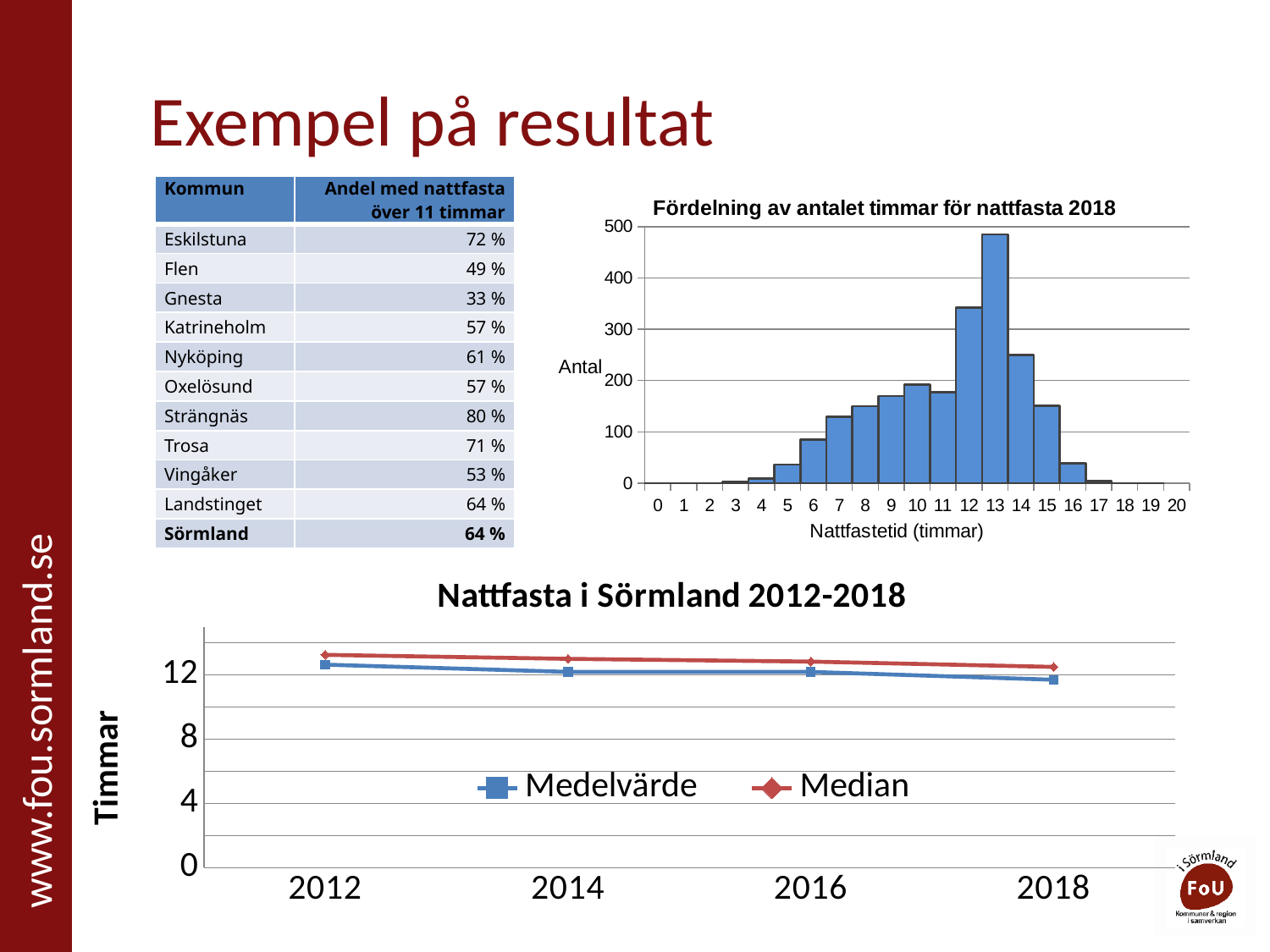
In the chart titled 'Fördelning av antalet timmar för nattfasta 2018', which is larger, the value for 12 hours or the value for 14 hours? 12 hours In the chart titled 'Nattfasta i Sörmland 2012-2018', is the Medelvärde value for 2018 greater or less than 12? less In the chart titled 'Fördelning av antalet timmar för nattfasta 2018', is the value for 13 hours greater or less than 400? greater What is the x-axis label of the chart titled 'Fördelning av antalet timmar för nattfasta 2018'? Nattfastetid (timmar) In the chart titled 'Nattfasta i Sörmland 2012-2018', do the Medelvärde values rise or fall from 2012 to 2018? fall How many series does the legend of the chart titled 'Nattfasta i Sörmland 2012-2018' list? 2 What kind of chart is 'Fördelning av antalet timmar för nattfasta 2018'? bar chart In the chart titled 'Fördelning av antalet timmar för nattfasta 2018', which nattfastetid (hours) has the highest count? 13 In the chart titled 'Fördelning av antalet timmar för nattfasta 2018', is the value for 12 hours greater or less than 300? greater In the chart titled 'Nattfasta i Sörmland 2012-2018', how many years are plotted on the x axis? 4